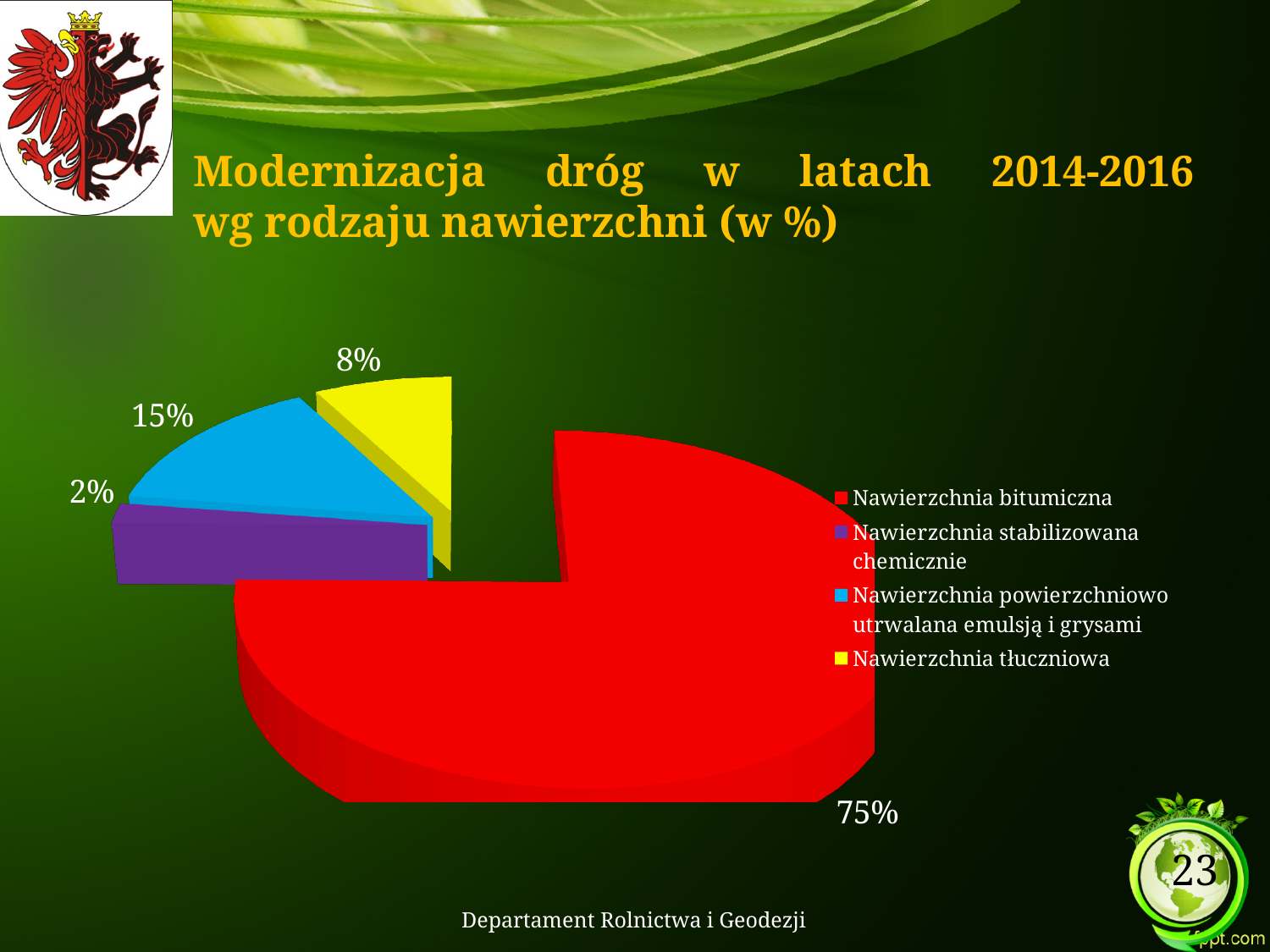
What share of the pie does Nawierzchnia bitumiczna have? 75% Which category has the largest slice of the pie? Nawierzchnia bitumiczna What colour is the slice for Nawierzchnia tłuczniowa? yellow How many entries does the legend list? 4 Which is larger, the share for Nawierzchnia tłuczniowa or the share for Nawierzchnia stabilizowana chemicznie? Nawierzchnia tłuczniowa What share of the pie does Nawierzchnia tłuczniowa have? 8% What is the difference in percentage points between Nawierzchnia bitumiczna and Nawierzchnia powierzchniowo utrwalana emulsją i grysami? 60 What kind of chart is shown on the slide? pie chart What share of the pie does Nawierzchnia powierzchniowo utrwalana emulsją i grysami have? 15% Which category has the smallest slice of the pie? Nawierzchnia stabilizowana chemicznie What share of the pie does Nawierzchnia stabilizowana chemicznie have? 2% How many slices does the pie chart have? 4